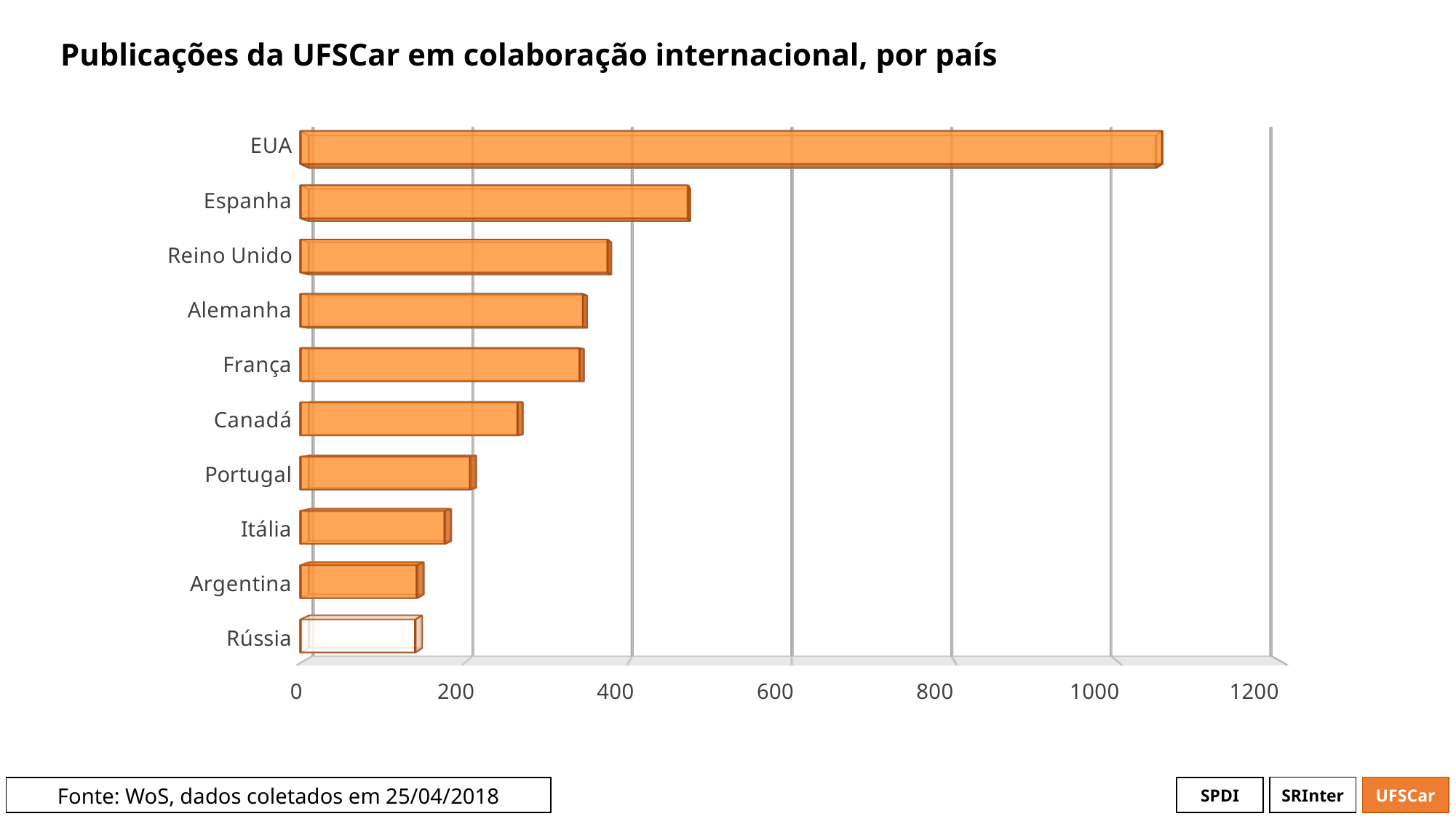
What is the title of the chart? Publicações da UFSCar em colaboração internacional, por país What kind of chart is shown on the slide? bar chart Is the value for EUA greater or less than 1000? greater Is the value for Itália greater or less than 200? less How many countries are shown in the chart? 10 Which has more publications, Espanha or Reino Unido? Espanha Is the value for Canadá greater or less than 200? greater Which has more publications, Canadá or Portugal? Canadá Which country's bar is drawn unfilled (white) instead of orange? Rússia Which country has the highest number of publications in international collaboration with UFSCar? EUA